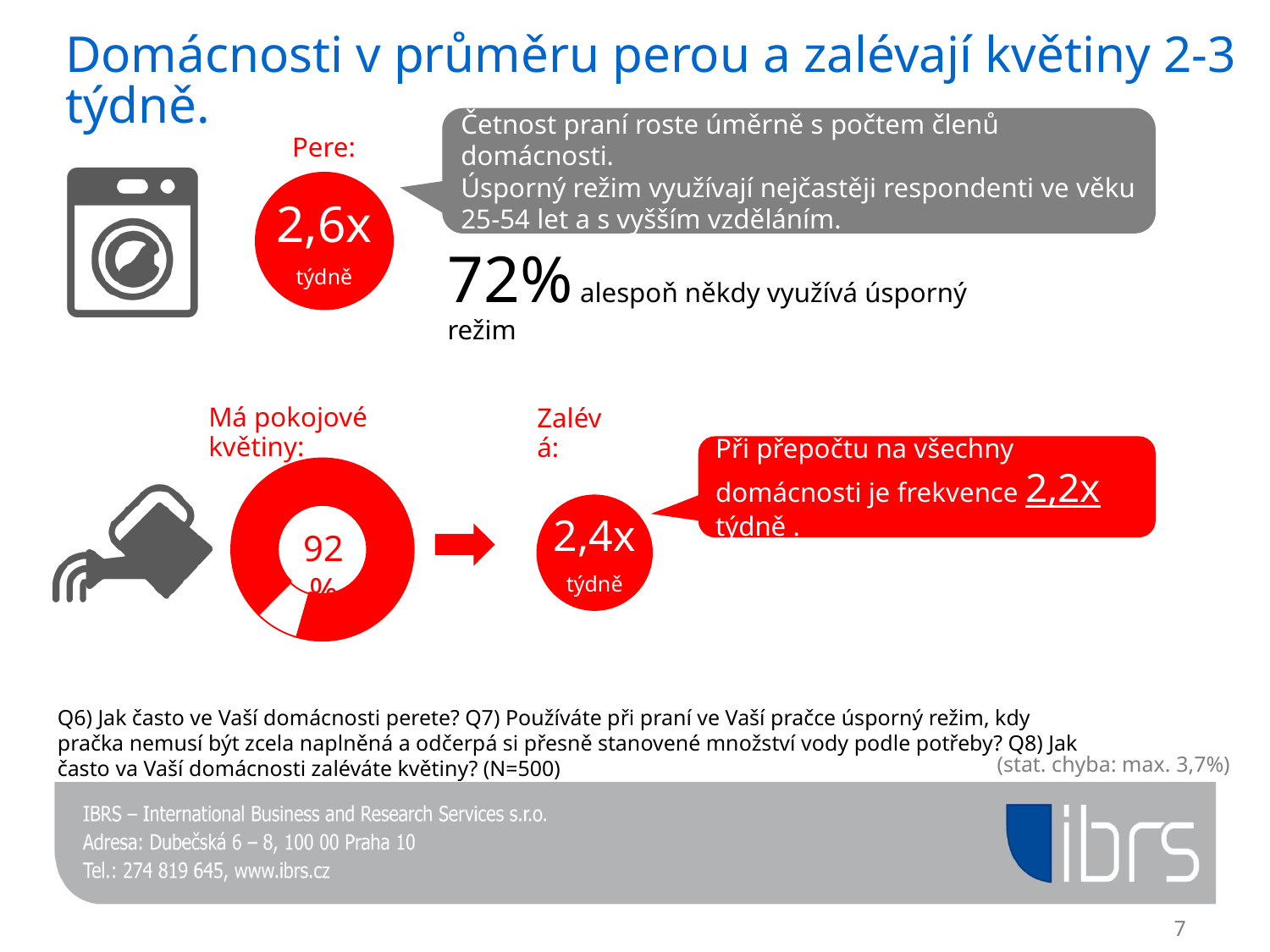
In the "Má pokojové květiny:" doughnut chart, is the large slice greater or less than 50%? greater How many slices does the "Má pokojové květiny:" doughnut chart have? 2 In the "Má pokojové květiny:" doughnut chart, what share of the whole does the small unlabelled slice represent? 8 % In the "Má pokojové květiny:" doughnut chart, which slice is larger, the one labelled 92 % or the unlabelled small slice? the one labelled 92 % What kind of chart is shown next to the watering-can icon under "Má pokojové květiny:"? doughnut chart What label is written in red above the doughnut chart? Má pokojové květiny: What colour is the large slice of the "Má pokojové květiny:" doughnut chart? red In the "Má pokojové květiny:" doughnut chart, what percentage is printed in the centre? 92 %